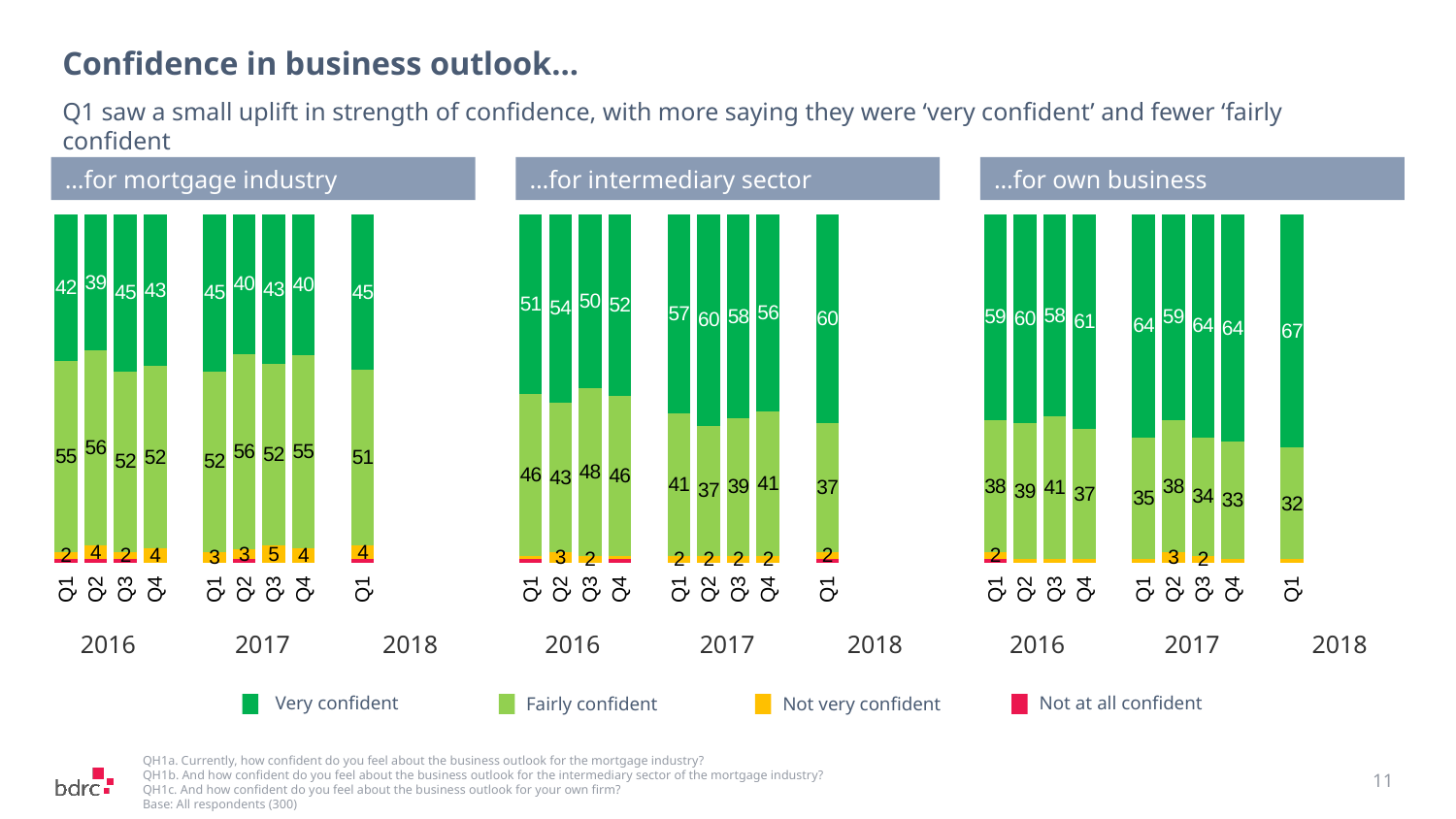
In the '...for own business' chart, what is the 'very confident' value for Q1 2018? 67 In the '...for intermediary sector' chart, what is the 'fairly confident' value for Q2 2017? 37 In the '...for own business' chart, what is the difference between the 'very confident' values for Q1 2018 and Q4 2017? 3 In the '...for own business' chart, does the 'fairly confident' value rise or fall from Q1 2017 to Q1 2018? Fall In the '...for mortgage industry' chart, which is larger: the 'fairly confident' value for Q2 2016 or for Q1 2018? Q2 2016 How many series does the legend list? 4 How many quarters (bars) are shown in the '...for intermediary sector' chart? 9 In the '...for intermediary sector' chart, which quarter has the lowest 'very confident' value? Q3 2016 Which legend entry is shown in yellow? Not very confident In the '...for own business' chart, which quarter has the highest 'very confident' value? Q1 2018 In the '...for mortgage industry' chart, what percentage were 'very confident' in Q1 2018? 45 What kind of chart is used for '...for own business'? Stacked bar chart